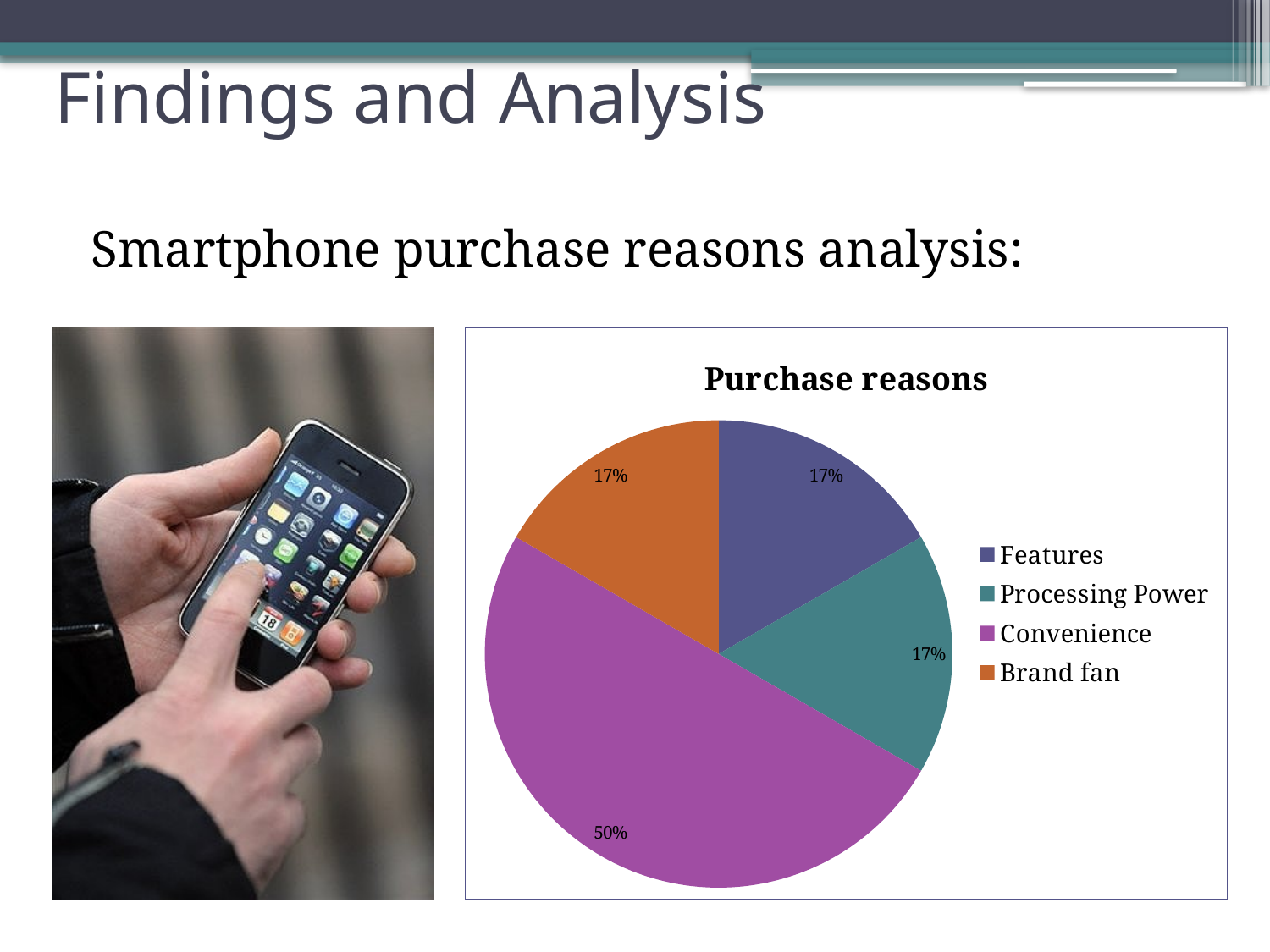
What kind of chart is shown on the slide? pie chart How many categories does the legend list? 4 Which is larger, the slice for Convenience or the slice for Brand fan? Convenience What share of the pie does Convenience take? 50% What share of the pie does Processing Power take? 17% What is the title of the chart? Purchase reasons What share of the pie does Brand fan take? 17% What is the difference in percentage points between the Convenience slice and the Features slice? 33 Which purchase reason has the largest slice? Convenience Which colour represents Convenience in the chart? purple